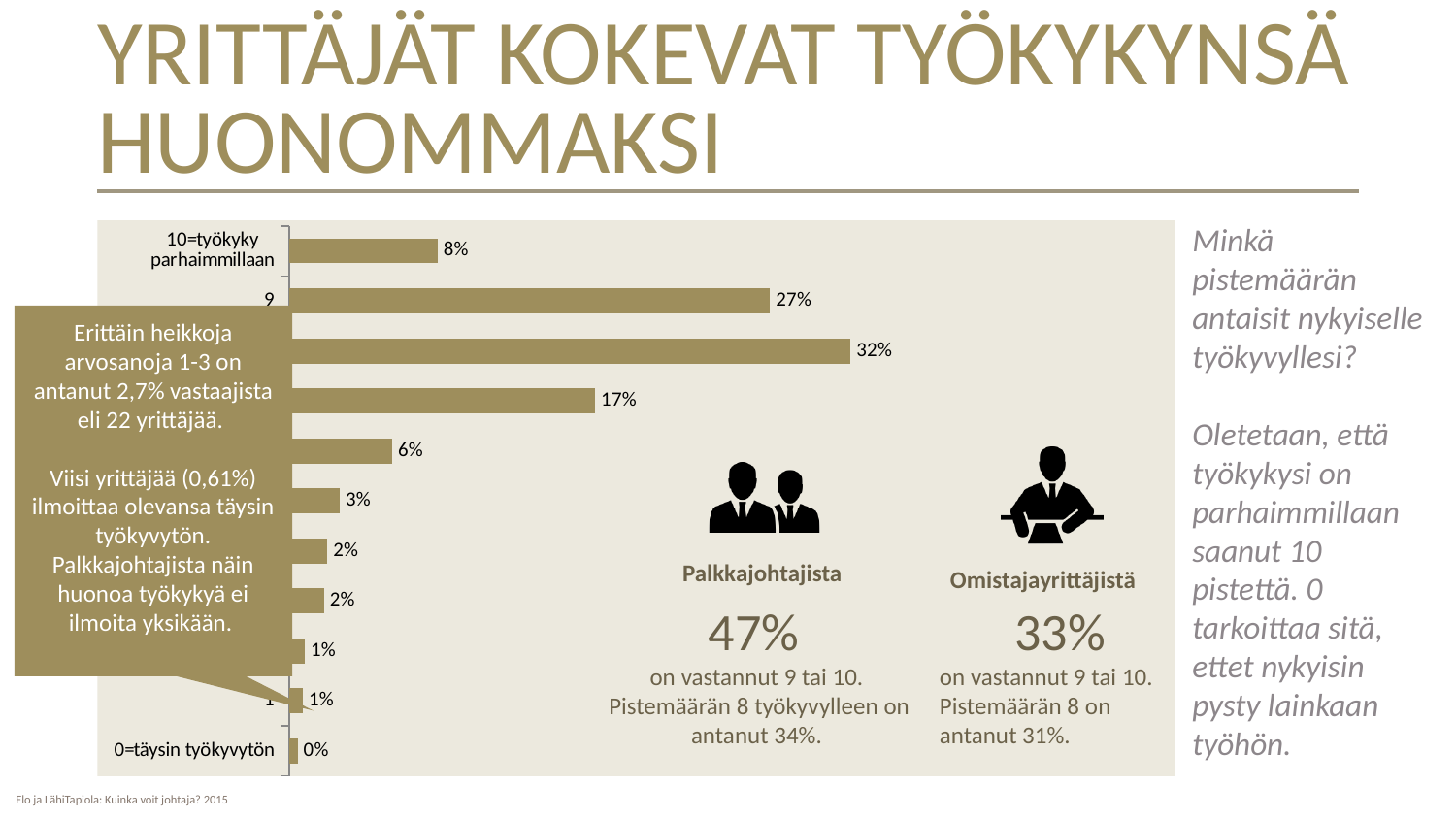
Which category has the lowest value on the bar chart? 0=täysin työkyvytön What is the second-highest percentage value shown on the bar chart? 27% What percentage is shown for the category "0=täysin työkyvytön"? 0% What is the difference between the value for "9" and the value for "10=työkyky parhaimmillaan"? 19% What percentage is shown for the category "10=työkyky parhaimmillaan"? 8% What is the title of the slide containing the bar chart? YRITTÄJÄT KOKEVAT TYÖKYKYNSÄ HUONOMMAKSI What percentage is shown for the category "9"? 27% How many bars are plotted on the bar chart? 11 What kind of chart is shown on the slide? bar chart What is the highest percentage value shown on the bar chart? 32% Which has a larger value, the category "9" or the category "10=työkyky parhaimmillaan"? 9 How many bars on the chart are labelled 2%? 2